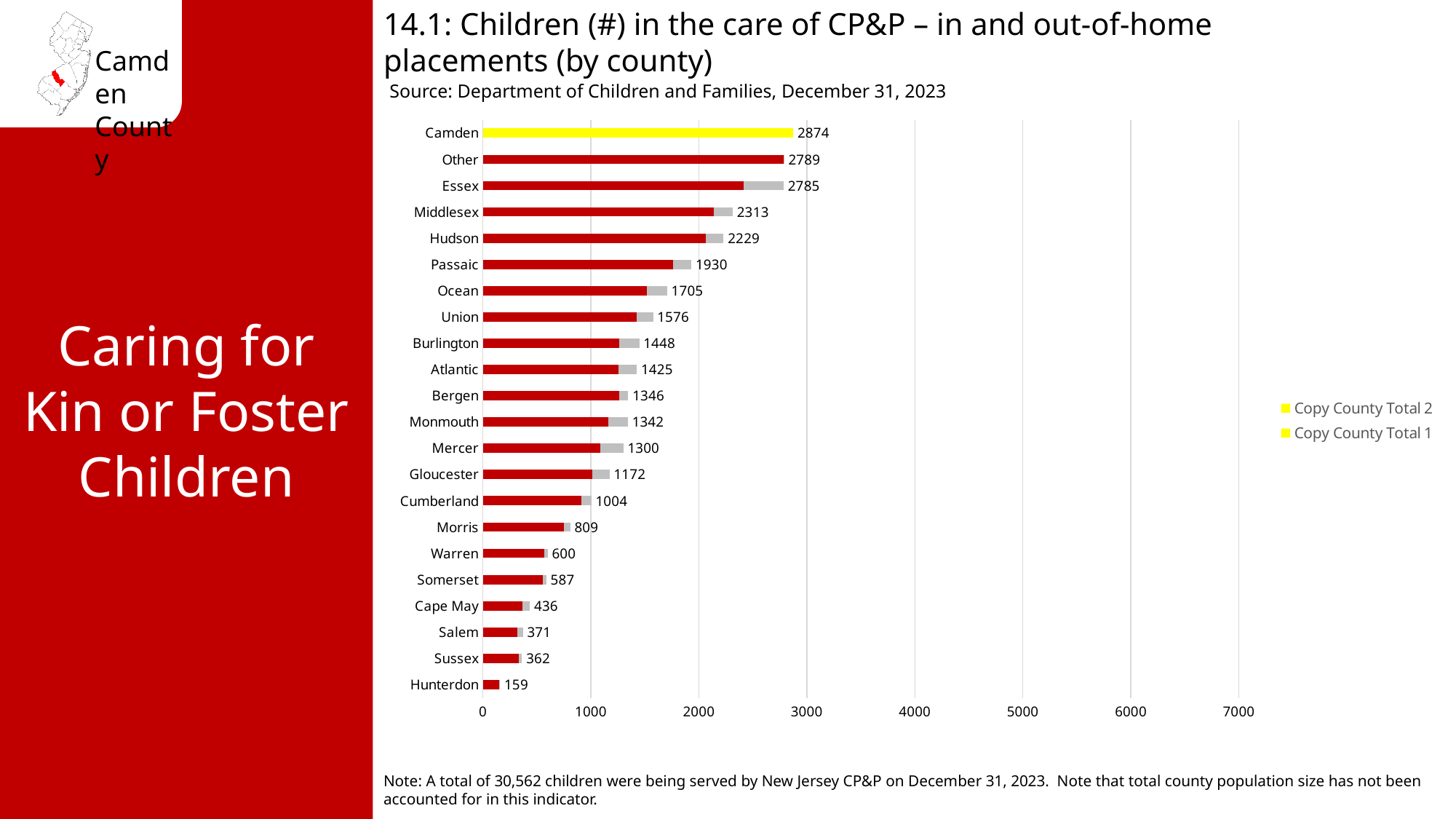
What is the difference between the totals for Morris and Warren? 209 How many series does the legend list? 2 Is the total value for Middlesex greater or less than 2000? greater What kind of chart is shown on the slide? Bar chart What is the total value shown for Cumberland? 1004 How many counties/categories are shown on the chart? 22 What is the total number of children in the care of CP&P for Camden? 2874 Which has a larger total, Passaic or Ocean? Passaic What is the difference between the totals for Camden and Essex? 89 Which county has the lowest total number of children in the care of CP&P? Hunterdon What is the total value shown for Hudson? 2229 Which county has the highest total number of children in the care of CP&P? Camden